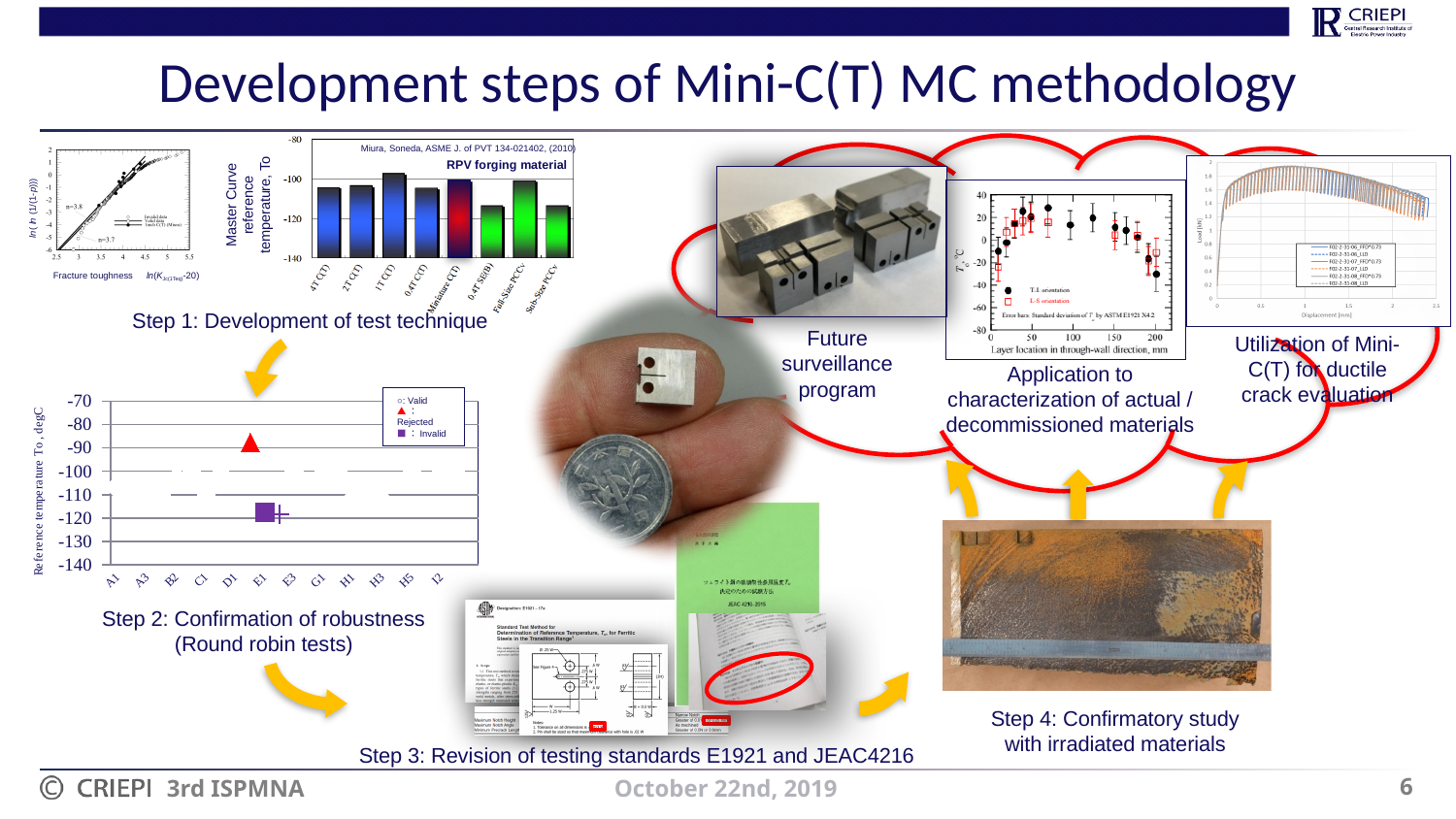
In the Step 2 round robin chart, is the 'Invalid' (purple square) value greater or less than -110? less What is the lowest value shown on the y axis of the Step 2 round robin reference temperature chart? -140 What is the x-axis label of the chart showing T0 for actual/decommissioned materials? Layer location in through-wall direction, mm How many entries does the legend of the Step 2 round robin reference temperature chart list? 3 In the 'Master Curve reference temperature, To' bar chart, is the value for Sub-Size PCCv greater or less than -100? less How many orientation series does the legend list in the chart of T0 versus layer location in through-wall direction? 2 In the Step 2 round robin chart, is the 'Rejected' (red triangle) value greater or less than -100? greater In the Step 2 round robin chart of reference temperature To, how many laboratory labels are listed along the x axis? 12 How many specimen categories are shown on the x axis of the 'Master Curve reference temperature, To' bar chart? 8 What kind of chart is the 'Master Curve reference temperature, To' chart for the RPV forging material? bar chart